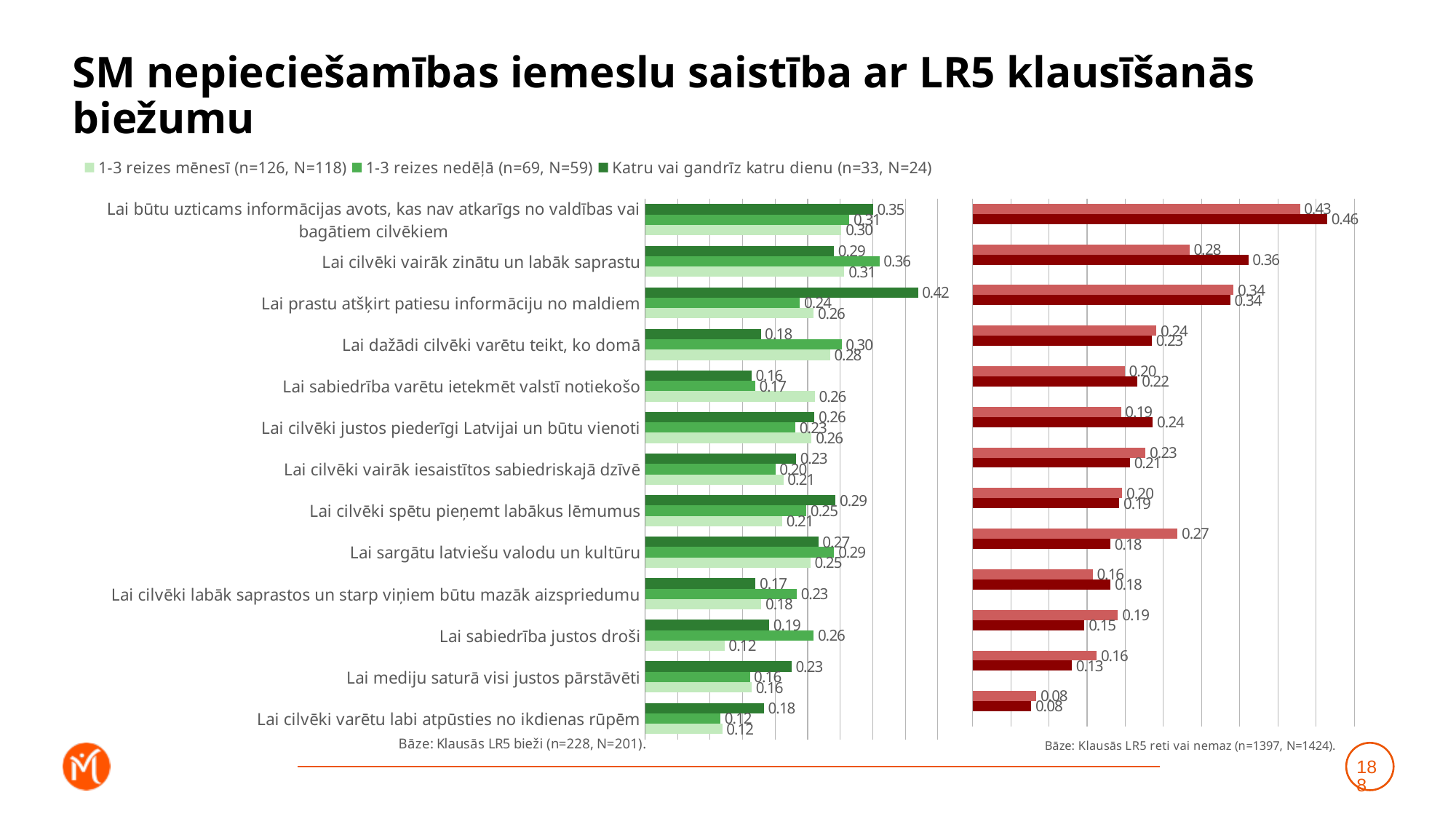
According to the legend of the left (green) chart, what sample sizes are given for the 'Katru vai gandrīz katru dienu' series? n=33, N=24 In the right (red) chart, which category has the highest value for the lighter red bars? Lai būtu uzticams informācijas avots, kas nav atkarīgs no valdības vai bagātiem cilvēkiem In the left (green) chart, what is the value for 'Katru vai gandrīz katru dienu' for 'Lai prastu atšķirt patiesu informāciju no maldiem'? 0.42 In the left (green) chart, for 'Lai dažādi cilvēki varētu teikt, ko domā', which series has the larger value: '1-3 reizes nedēļā' or 'Katru vai gandrīz katru dienu'? 1-3 reizes nedēļā How many categories (reasons) are shown in the left (green) chart? 13 In the left (green) chart, which category has the highest value for the 'Katru vai gandrīz katru dienu' series? Lai prastu atšķirt patiesu informāciju no maldiem In the left (green) chart, which category has the lowest value for the '1-3 reizes nedēļā' series? Lai cilvēki varētu labi atpūsties no ikdienas rūpēm How many series does the legend of the left (green) chart list? 3 In the right (red) chart, what is the value of the darker red bar for 'Lai būtu uzticams informācijas avots, kas nav atkarīgs no valdības vai bagātiem cilvēkiem'? 0.46 What kind of chart is used on this slide? Bar chart In the left (green) chart, what is the value for '1-3 reizes mēnesī' for 'Lai sabiedrība justos droši'? 0.12 In the left (green) chart, for 'Lai prastu atšķirt patiesu informāciju no maldiem', what is the difference between the 'Katru vai gandrīz katru dienu' value and the '1-3 reizes nedēļā' value? 0.18